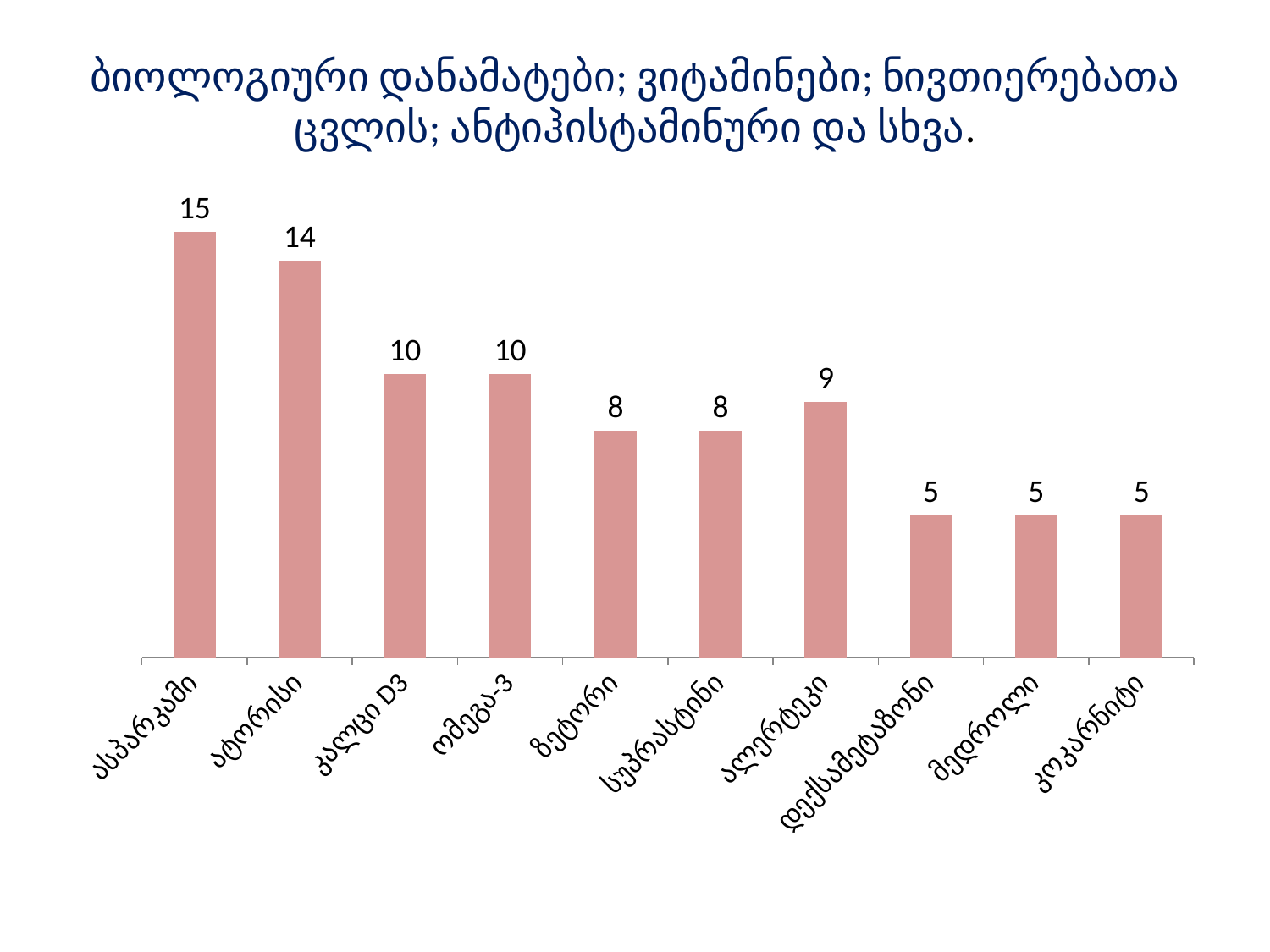
Which is larger, the value for ომეგა-3 or the value for კოკარნიტი? ომეგა-3 Which is larger, the value for ალერტეკი or the value for ზეტორი? ალერტეკი What is the difference between the values for კალცი D3 and მედროლი? 5 What is the difference between the values for ასპარკამი and ატორისი? 1 Which category has the highest value? ასპარკამი What is the value for სუპრასტინი? 8 What kind of chart is shown on the slide? bar chart What is the value for ასპარკამი? 15 How many categories are shown on the chart? 10 What colour are the bars in the chart? pink What is the value for დექსამეტაზონი? 5 What is the value for ალერტეკი? 9